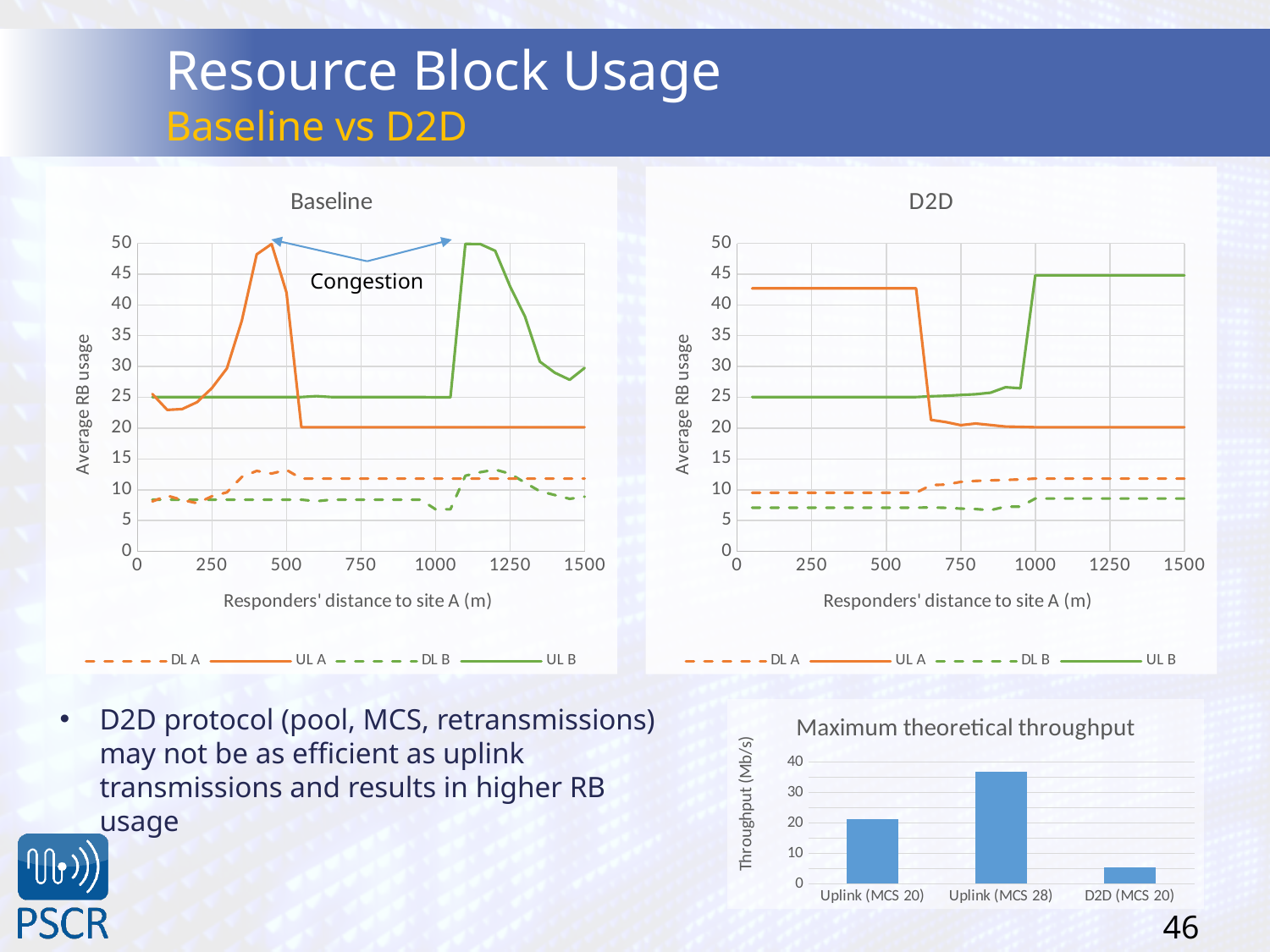
In the "Maximum theoretical throughput" chart, is the value for Uplink (MCS 28) greater or less than 30? greater How many series does the legend of the "Baseline" chart list? 4 In the "Baseline" chart, is the value of UL A at 1500 m greater or less than 25? less In the "Maximum theoretical throughput" chart, is the value for D2D (MCS 20) greater or less than 10? less How many categories are shown in the "Maximum theoretical throughput" chart? 3 What kind of chart is the "Maximum theoretical throughput" chart? bar chart What kind of chart is the "Baseline" chart? line chart In the "Maximum theoretical throughput" chart, which category has the highest throughput? Uplink (MCS 28) In the "Maximum theoretical throughput" chart, which category has the lowest throughput? D2D (MCS 20) What is the y-axis label of the "Baseline" chart? Average RB usage In the "D2D" chart, which series is larger at 250 m, UL A or UL B? UL A